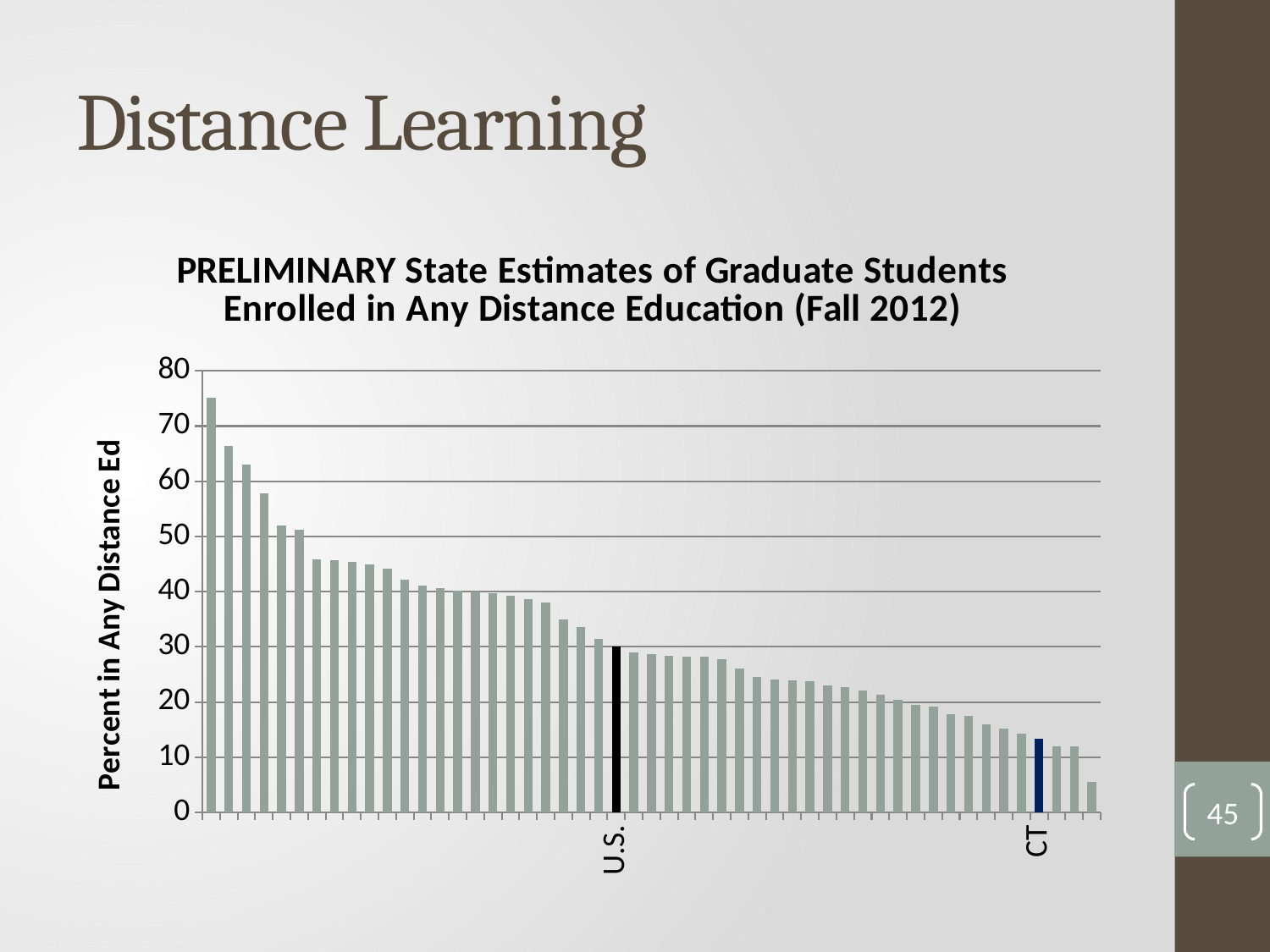
Which two bars are labeled on the x axis? U.S. and CT Is the tallest bar in the chart greater or less than 70? greater Is the value for U.S. greater or less than 40? less Do the bar values rise or fall moving from left to right along the x axis? fall Is the value for CT greater or less than 10? greater What is the title of the chart? PRELIMINARY State Estimates of Graduate Students Enrolled in Any Distance Education (Fall 2012) Which has the larger value, U.S. or CT? U.S. What is the label on the vertical axis of the chart? Percent in Any Distance Ed What kind of chart is shown on the slide? bar chart